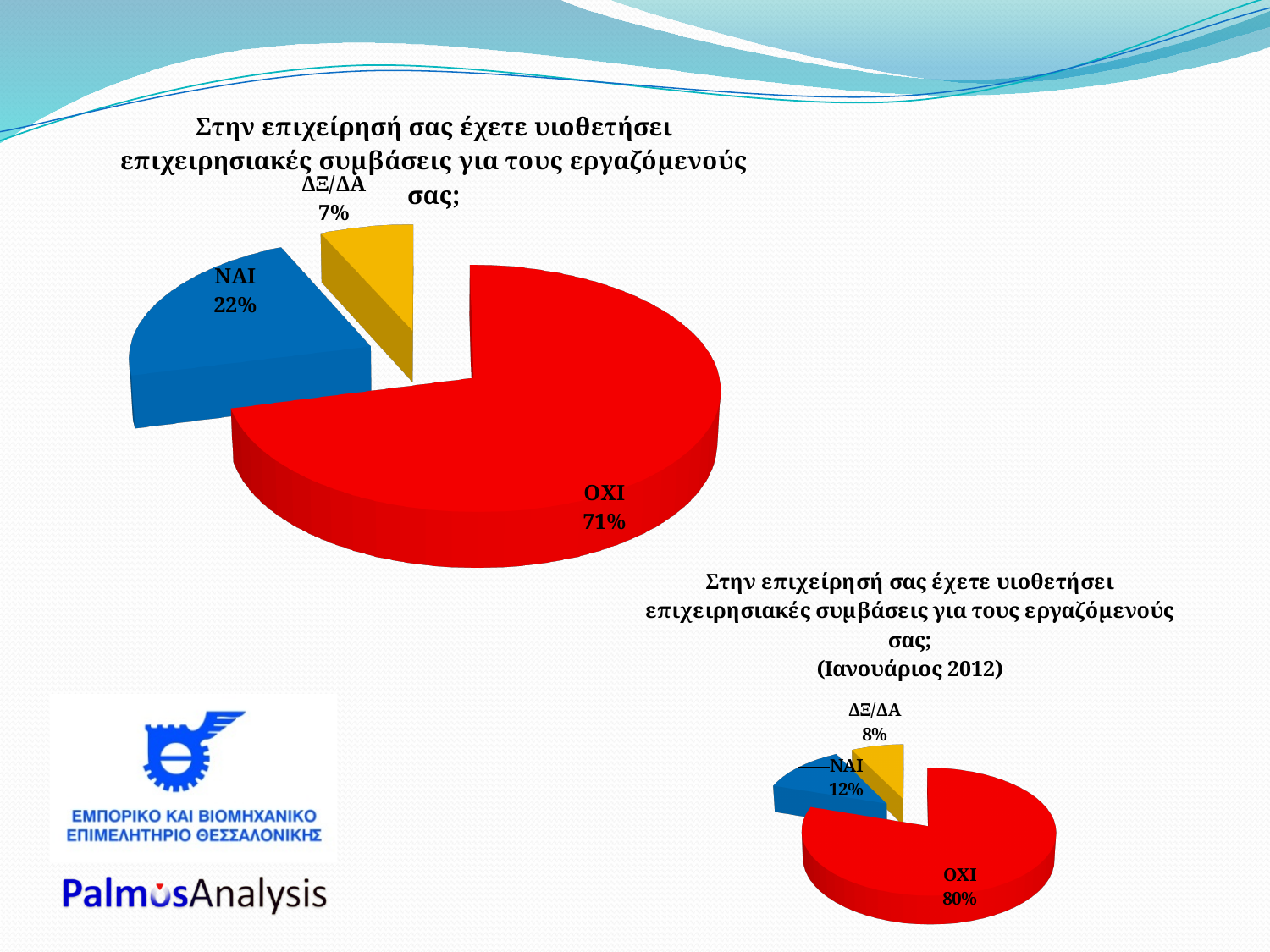
In the top-left pie chart, what share is labelled ΟΧΙ? 71% In the bottom-right pie chart (Ιανουάριος 2012), what share is labelled ΔΞ/ΔΑ? 8% Which chart shows a larger share for ΝΑΙ, the top-left chart or the bottom-right chart (Ιανουάριος 2012)? the top-left chart What type of chart is the top-left chart? pie chart In the top-left pie chart, what is the difference in percentage points between ΟΧΙ and ΝΑΙ? 49 How many slices does the bottom-right pie chart (Ιανουάριος 2012) have? 3 In the top-left pie chart, what share is labelled ΝΑΙ? 22% In the bottom-right pie chart (Ιανουάριος 2012), which category has the smallest slice? ΔΞ/ΔΑ In the top-left pie chart, what share is labelled ΔΞ/ΔΑ? 7% In the bottom-right pie chart (Ιανουάριος 2012), what share is labelled ΝΑΙ? 12% In the bottom-right pie chart (Ιανουάριος 2012), what share is labelled ΟΧΙ? 80% In the top-left pie chart, which category has the largest slice? ΟΧΙ